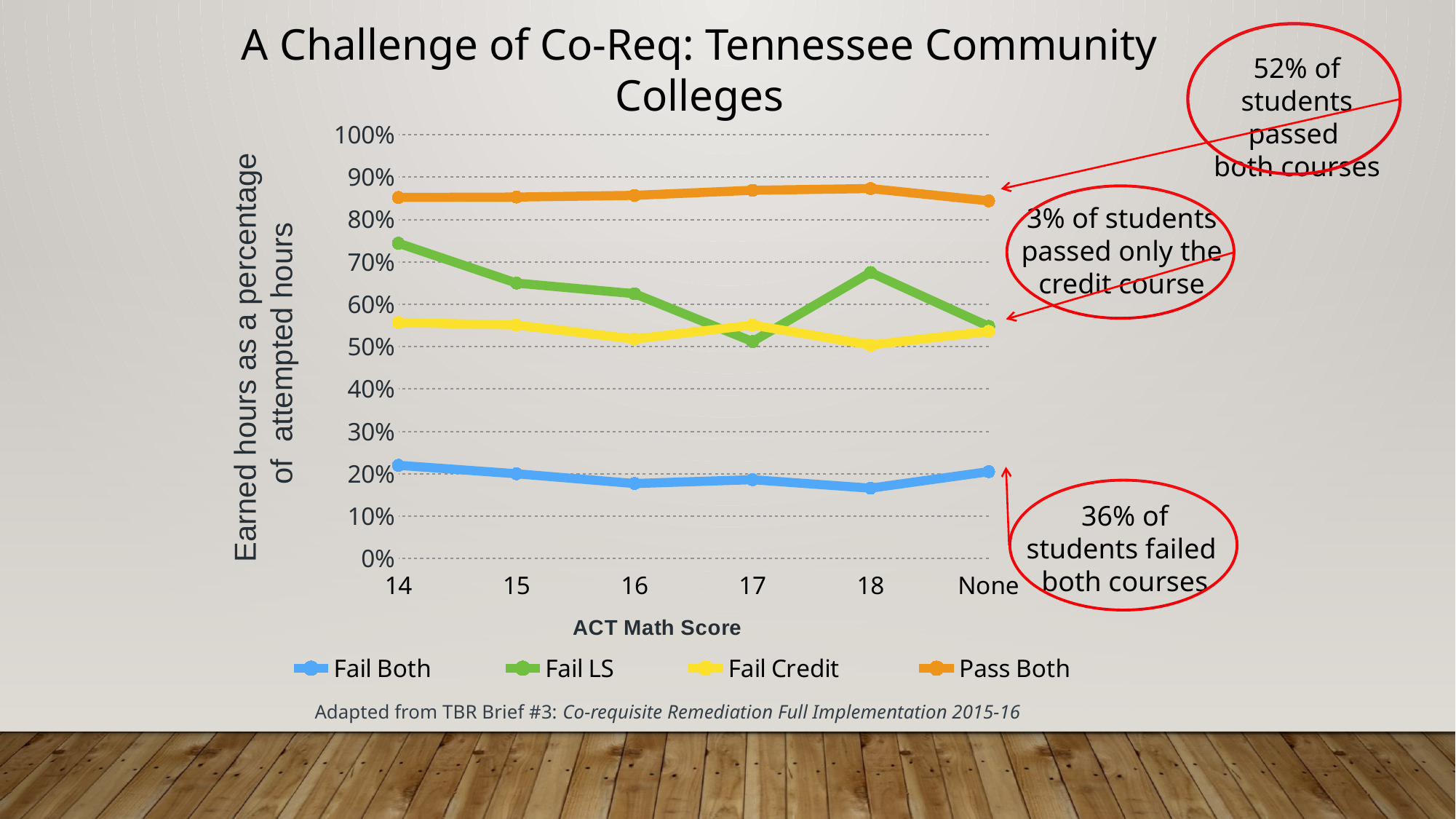
What kind of chart is shown on the slide? line chart Is the value for Fail LS at an ACT Math Score of 14 greater or less than 70%? greater At an ACT Math Score of 18, which is larger: Fail LS or Fail Credit? Fail LS How many series does the legend list? 4 Which series has the lowest value at an ACT Math Score of 18? Fail Both Does the Fail LS line rise or fall from an ACT Math Score of 14 to 17? fall Is the value for Pass Both at an ACT Math Score of 14 greater or less than 80%? greater What is the title of the x axis? ACT Math Score Is the value for Fail Both at an ACT Math Score of 18 greater or less than 20%? less Which series has the highest value at an ACT Math Score of 14? Pass Both How many ACT Math Score categories are plotted along the x axis? 6